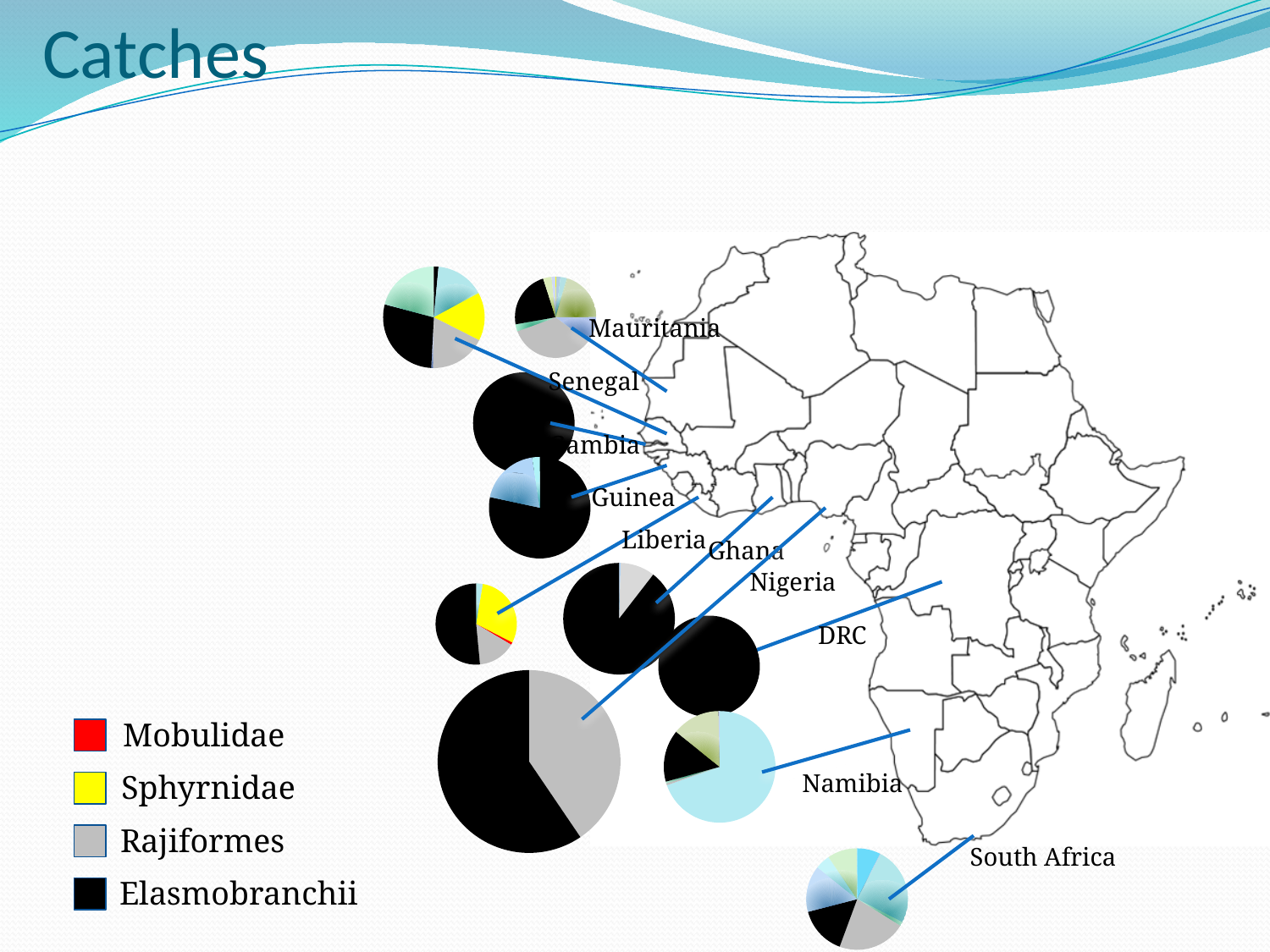
In the Liberia pie chart, which legend category has the smallest slice? Mobulidae How many countries are labelled with a pie chart on the map? 10 Which colour represents Elasmobranchii in the legend? Black How many categories does the legend list? 4 What kind of chart is used to show the catches for each country on the map? Pie chart What is the title of the slide containing the pie charts? Catches In the Nigeria pie chart, which is larger: the Elasmobranchii slice or the Rajiformes slice? Elasmobranchii In the Gambia pie chart, which category makes up essentially the whole pie? Elasmobranchii In the Liberia pie chart, which is larger: the Sphyrnidae slice or the Elasmobranchii slice? Elasmobranchii In the DRC pie chart, which category has the largest slice? Elasmobranchii In the Ghana pie chart, which category has the largest slice? Elasmobranchii